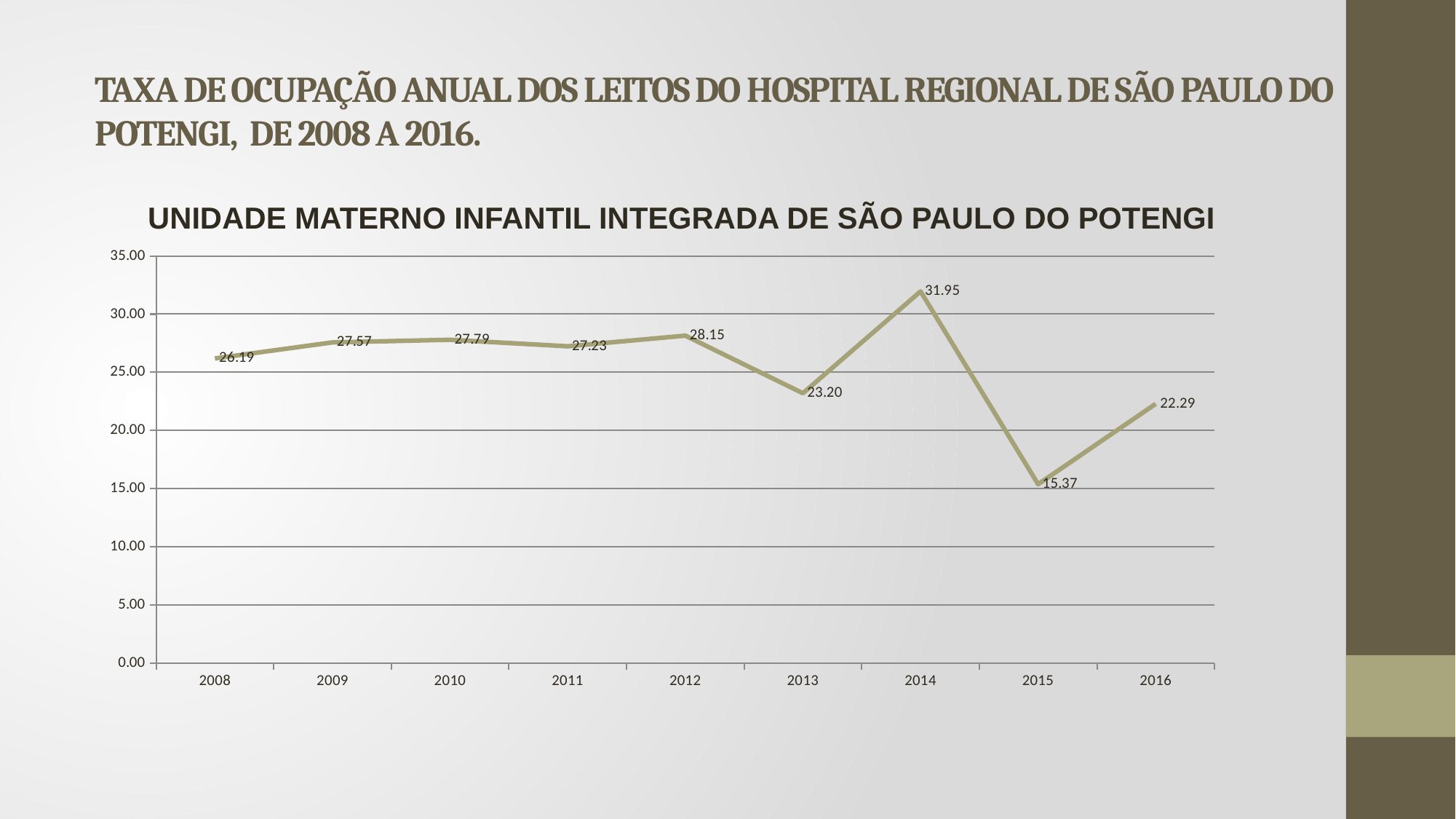
Which year has the highest value? 2014 What kind of chart is shown? line chart What is the difference between the values for 2014 and 2015? 16.58 Does the value rise or fall from 2014 to 2015? fall What is the title of the chart? UNIDADE MATERNO INFANTIL INTEGRADA DE SÃO PAULO DO POTENGI How many years are plotted on the chart? 9 What is the value for 2016? 22.29 What is the value for 2008? 26.19 What is the value for 2014? 31.95 Which year has the lowest value? 2015 Which is larger, the value for 2012 or the value for 2013? 2012 Is the value for 2015 greater or less than 20.00? less